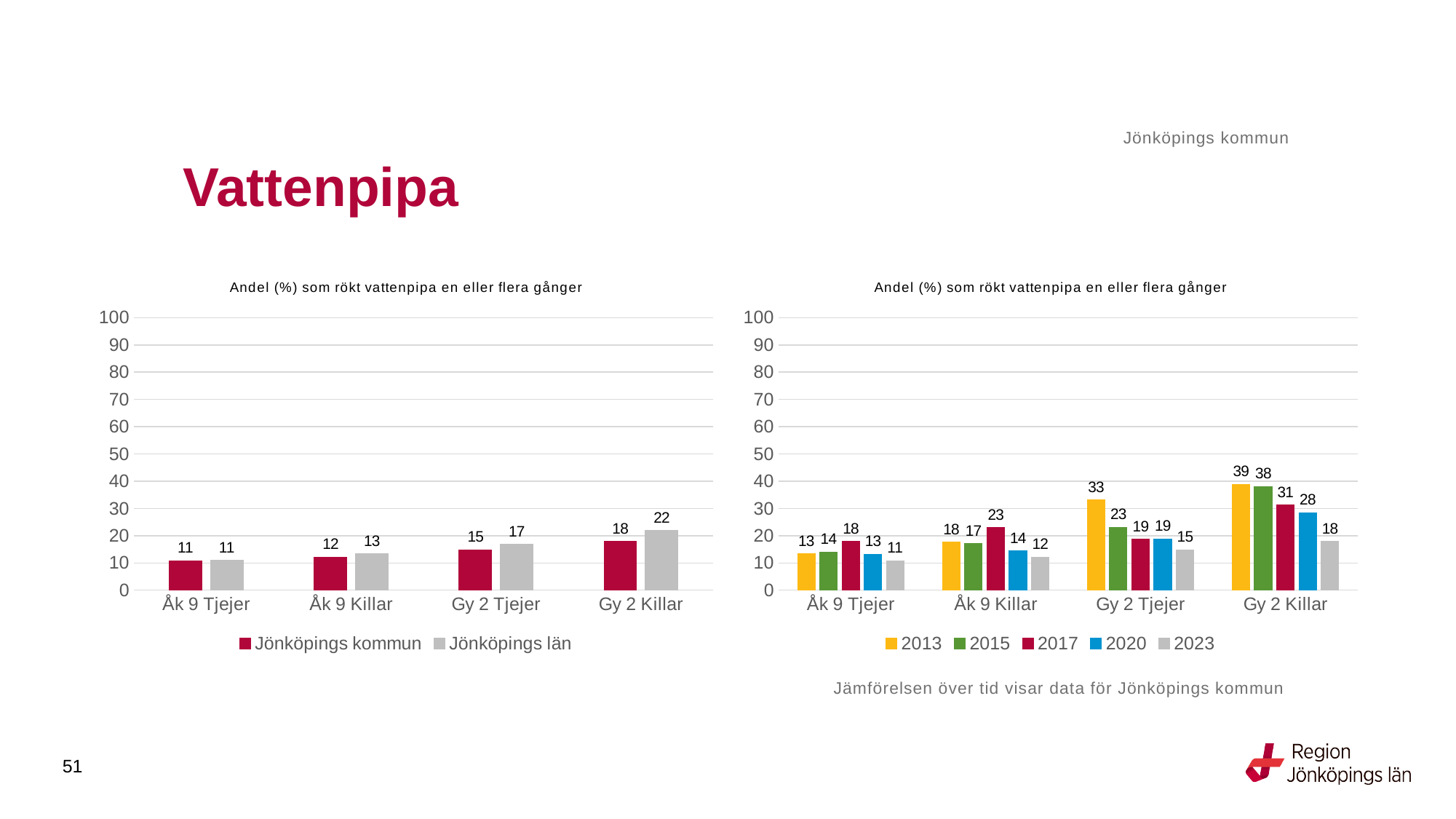
In the right chart, what is the value for 2013 for Gy 2 Killar? 39 In the right chart, how many series does the legend list? 5 In the right chart, is the value for 2017 for Åk 9 Killar larger than the value for 2020 for Åk 9 Killar? Yes In the right chart, which year has the lowest value for Gy 2 Tjejer? 2023 In the left chart, what is the value for Jönköpings kommun for Gy 2 Tjejer? 15 In the left chart, how many series does the legend list? 2 In the right chart, what is the difference between the 2013 and 2023 values for Gy 2 Killar? 21 In the left chart, what is the value for Jönköpings län for Gy 2 Killar? 22 In the left chart, what is the difference between Jönköpings län and Jönköpings kommun for Gy 2 Killar? 4 In the right chart, what is the value for 2023 for Åk 9 Tjejer? 11 In the left chart, which category has the highest value for Jönköpings kommun? Gy 2 Killar What kind of chart is the right chart? Bar chart